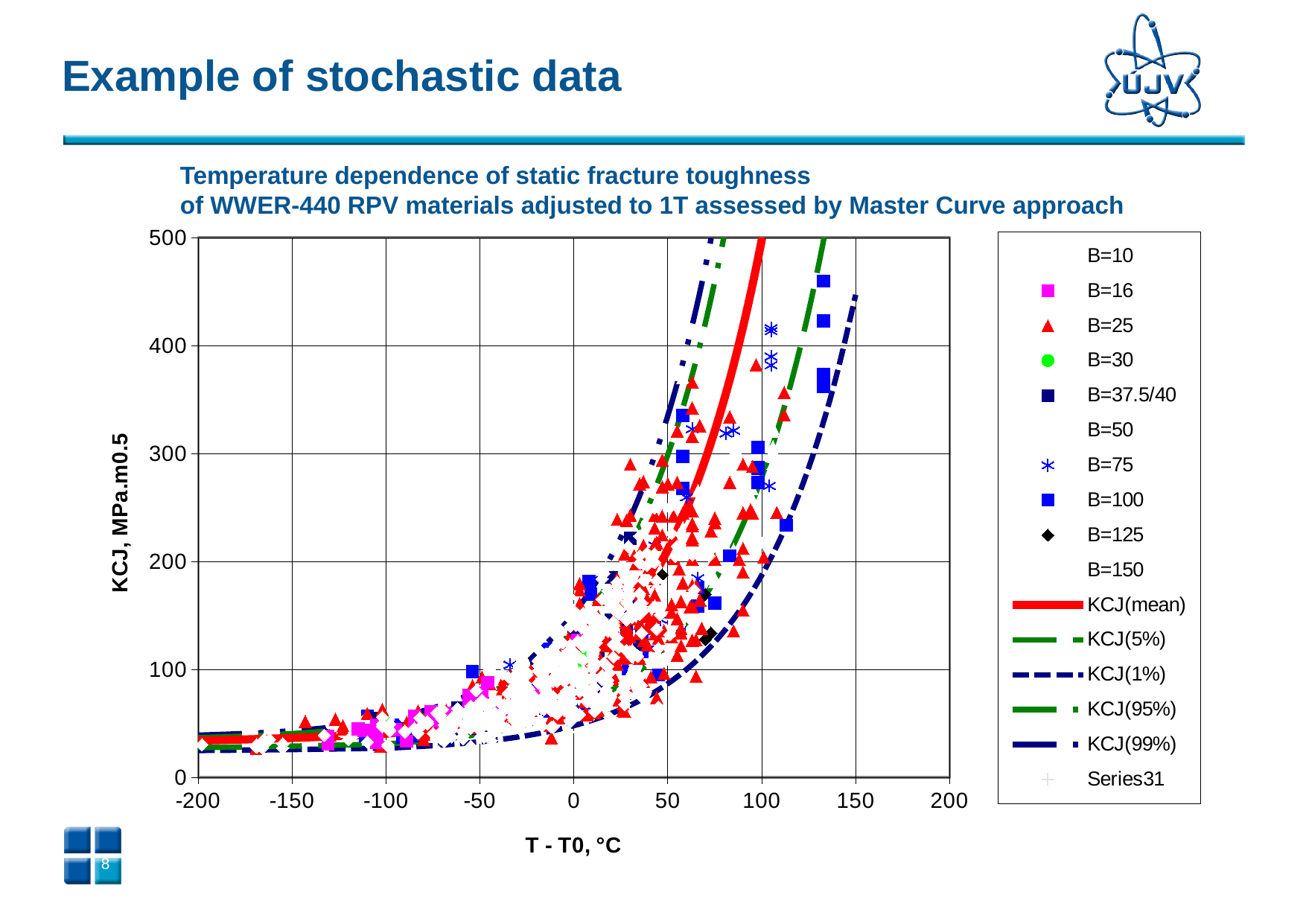
Is the value of the KCJ(mean) curve at T - T0 = -200 °C greater or less than 100? less Does the KCJ(mean) curve rise or fall as T - T0 increases? rises What is the minimum value shown on the x axis? -200 Is the value of the KCJ(1%) curve at T - T0 = 150 °C greater or less than 400? greater Is the value of the KCJ(99%) curve at T - T0 = 50 °C greater or less than 300? greater What is the maximum value shown on the y axis? 500 What is the label of the x axis? T - T0, °C What kind of chart is shown on the slide? scatter chart What is the title of the chart? Temperature dependence of static fracture toughness of WWER-440 RPV materials adjusted to 1T assessed by Master Curve approach How many entries does the chart legend list? 16 At T - T0 = 100 °C, which curve is higher: KCJ(mean) or KCJ(1%)? KCJ(mean)